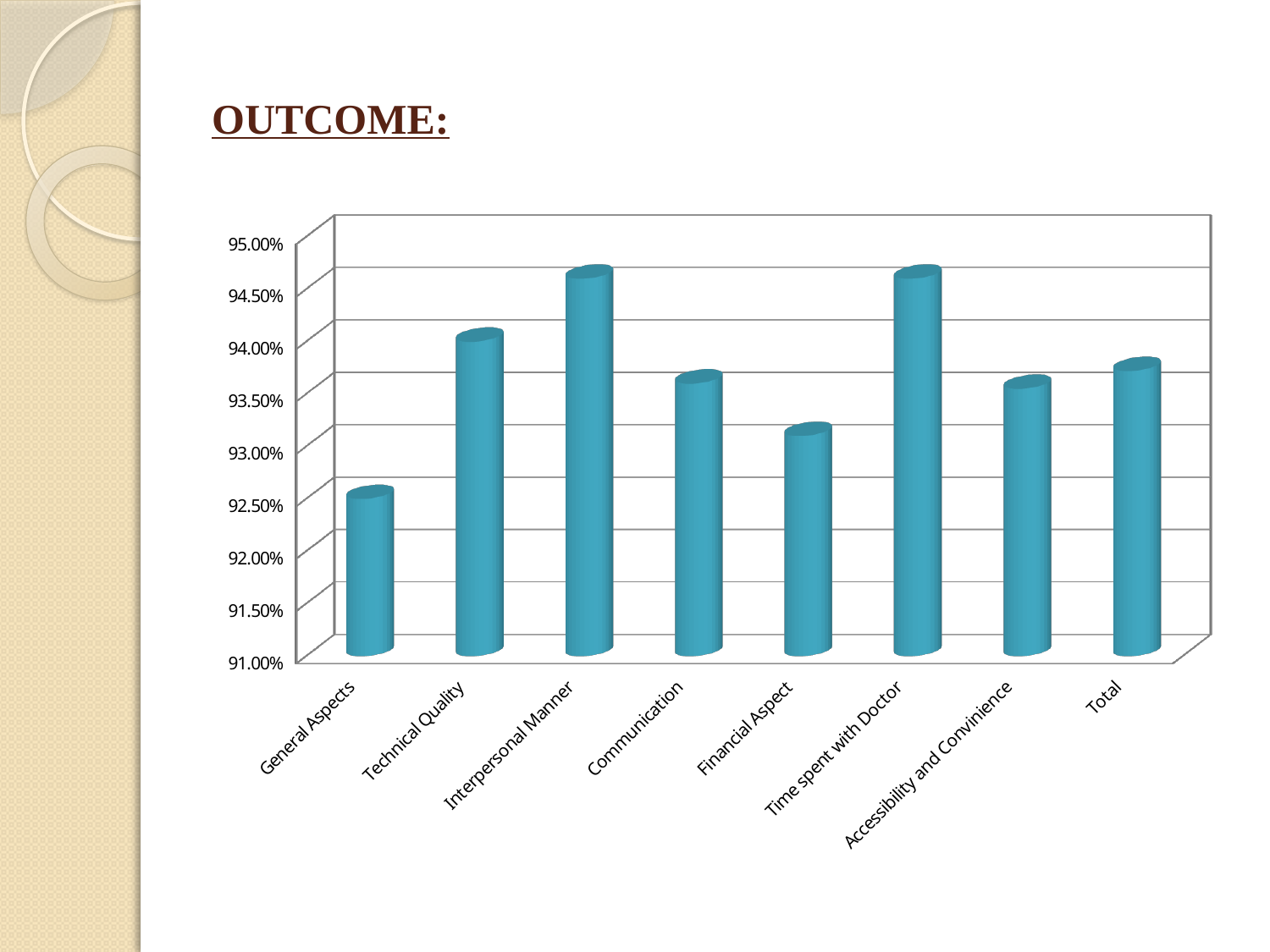
Is the value for Interpersonal Manner greater or less than 94.00%? greater Is the value for Technical Quality greater or less than 93.50%? greater Which is larger, the value for Technical Quality or the value for Financial Aspect? Technical Quality Is the value for Total greater or less than 93.00%? greater Which category has the lowest value in the chart? General Aspects Which is larger, the value for General Aspects or the value for Communication? Communication What is the title shown above the chart on the slide? OUTCOME: How many categories are plotted on the x axis of the chart? 8 What kind of chart is shown on the slide? Bar chart